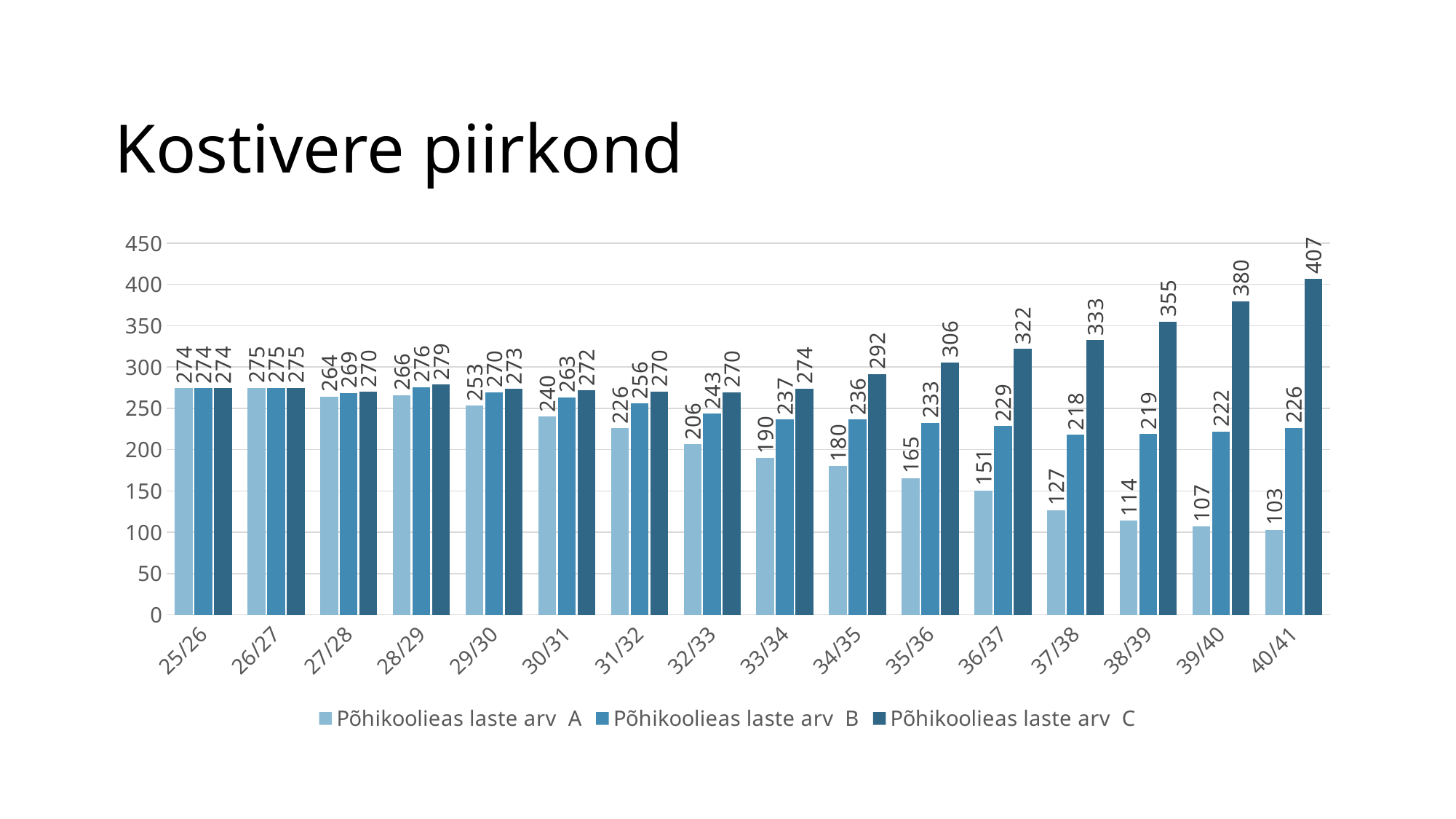
What is the value of Põhikoolieas laste arv C for 40/41? 407 What kind of chart is shown on the slide? bar chart What is the value of Põhikoolieas laste arv A for 33/34? 190 What is the title of the slide? Kostivere piirkond What is the difference between Põhikoolieas laste arv C and Põhikoolieas laste arv A for 39/40? 273 Which category has the lowest value for Põhikoolieas laste arv A? 40/41 Which category has the highest value for Põhikoolieas laste arv C? 40/41 Which is larger for 36/37: Põhikoolieas laste arv B or Põhikoolieas laste arv C? Põhikoolieas laste arv C What is the value of Põhikoolieas laste arv B for 37/38? 218 Do the values for Põhikoolieas laste arv A rise or fall from 26/27 to 40/41? fall How many series does the legend list? 3 How many categories are shown on the x axis? 16